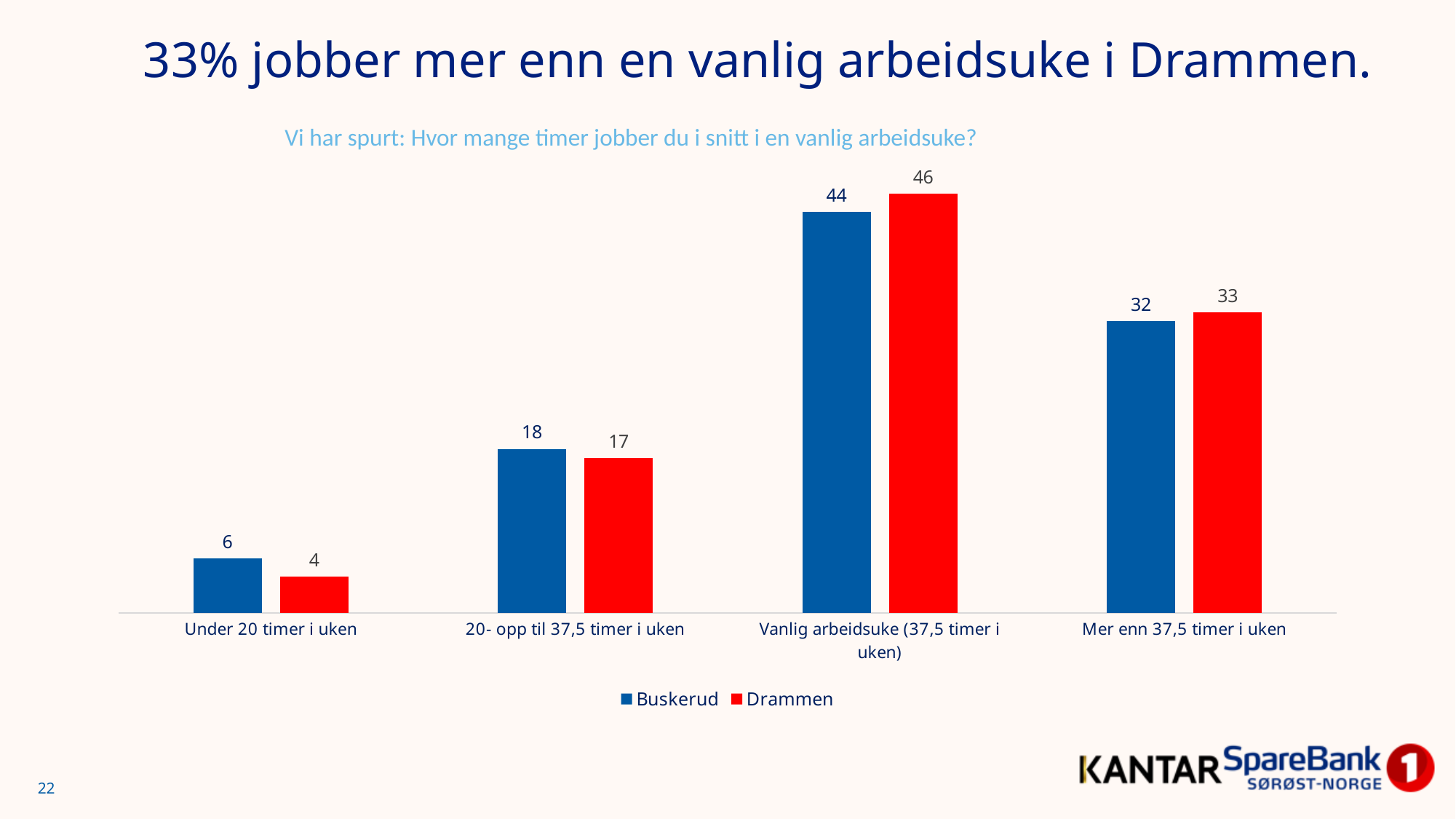
What is the value for Buskerud in the 'Under 20 timer i uken' category? 6 What kind of chart is shown on the slide? Bar chart What question was asked, according to the subtitle above the chart? Hvor mange timer jobber du i snitt i en vanlig arbeidsuke? What is the difference between Drammen and Buskerud in the 'Vanlig arbeidsuke (37,5 timer i uken)' category? 2 Which category has the lowest value for Drammen? Under 20 timer i uken How many categories are shown on the x axis? 4 What is the value for Drammen in the '20- opp til 37,5 timer i uken' category? 17 Which colour represents Drammen in the chart? Red What is the value for Drammen in the 'Mer enn 37,5 timer i uken' category? 33 In the 'Under 20 timer i uken' category, which series has the larger value, Buskerud or Drammen? Buskerud Which category has the highest value for Buskerud? Vanlig arbeidsuke (37,5 timer i uken) How many series does the legend list? 2